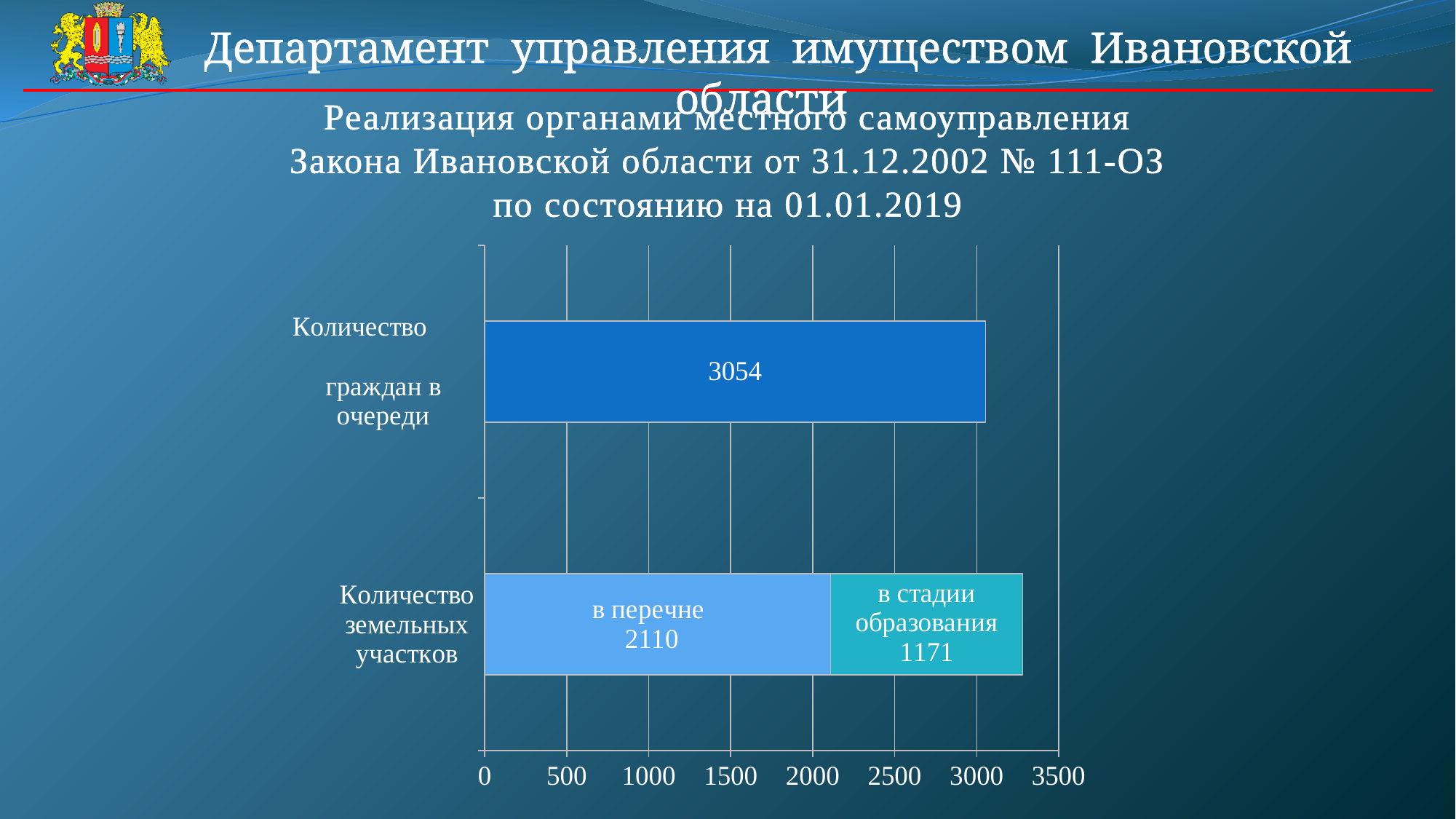
Is the "в стадии образования" segment greater or less than 1500? less What is the value shown for "Количество граждан в очереди"? 3054 What is the total of the stacked "Количество земельных участков" bar? 3281 What is the value of the "в перечне" segment of the "Количество земельных участков" bar? 2110 What kind of chart is shown on the slide? bar chart What is the maximum value shown on the horizontal axis of the chart? 3500 What is the value of the "в стадии образования" segment of the "Количество земельных участков" bar? 1171 Is the value for "Количество граждан в очереди" greater or less than 3000? greater What is the difference between the "в перечне" segment (2110) and the "в стадии образования" segment (1171)? 939 What date is the chart data reported as of, according to the chart title? 01.01.2019 Which is larger: the "в перечне" segment or the "в стадии образования" segment? в перечне How many categories are shown on the vertical axis of the chart? 2